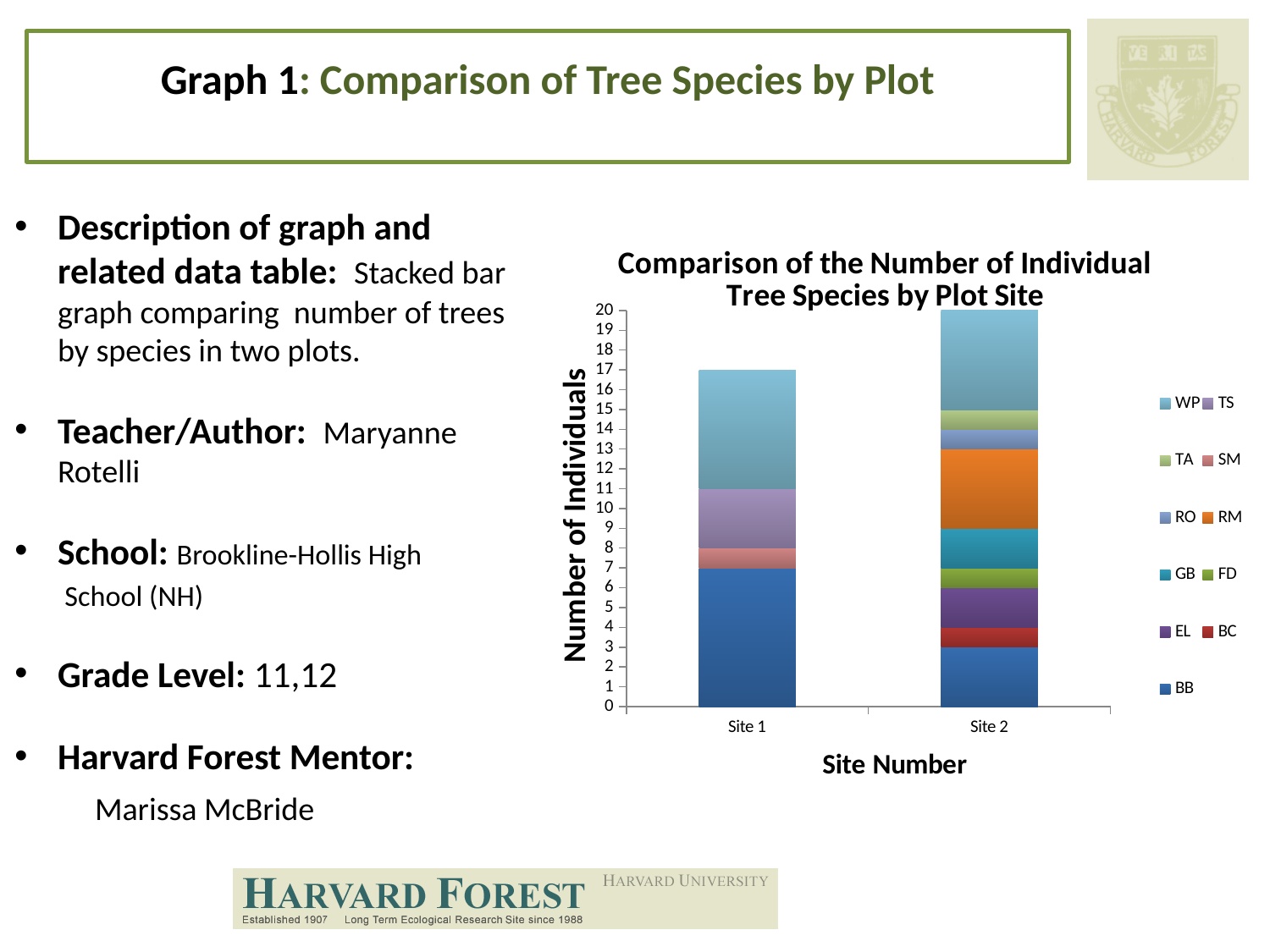
Which site has the taller stacked bar? Site 2 Is the BB segment for Site 2 greater or less than 5? less What is the total number of individuals for Site 1? 17 What kind of chart is shown on the slide? Stacked bar chart What is the difference between the total for Site 2 and the total for Site 1? 3 Which site has the shorter stacked bar? Site 1 What is the total number of individuals for Site 2? 20 How many species does the chart's legend list? 11 What is the label of the chart's y axis? Number of Individuals Is the total for Site 1 greater or less than 15? greater What is the title of the chart? Comparison of the Number of Individual Tree Species by Plot Site How many sites are plotted on the x axis of the chart? 2